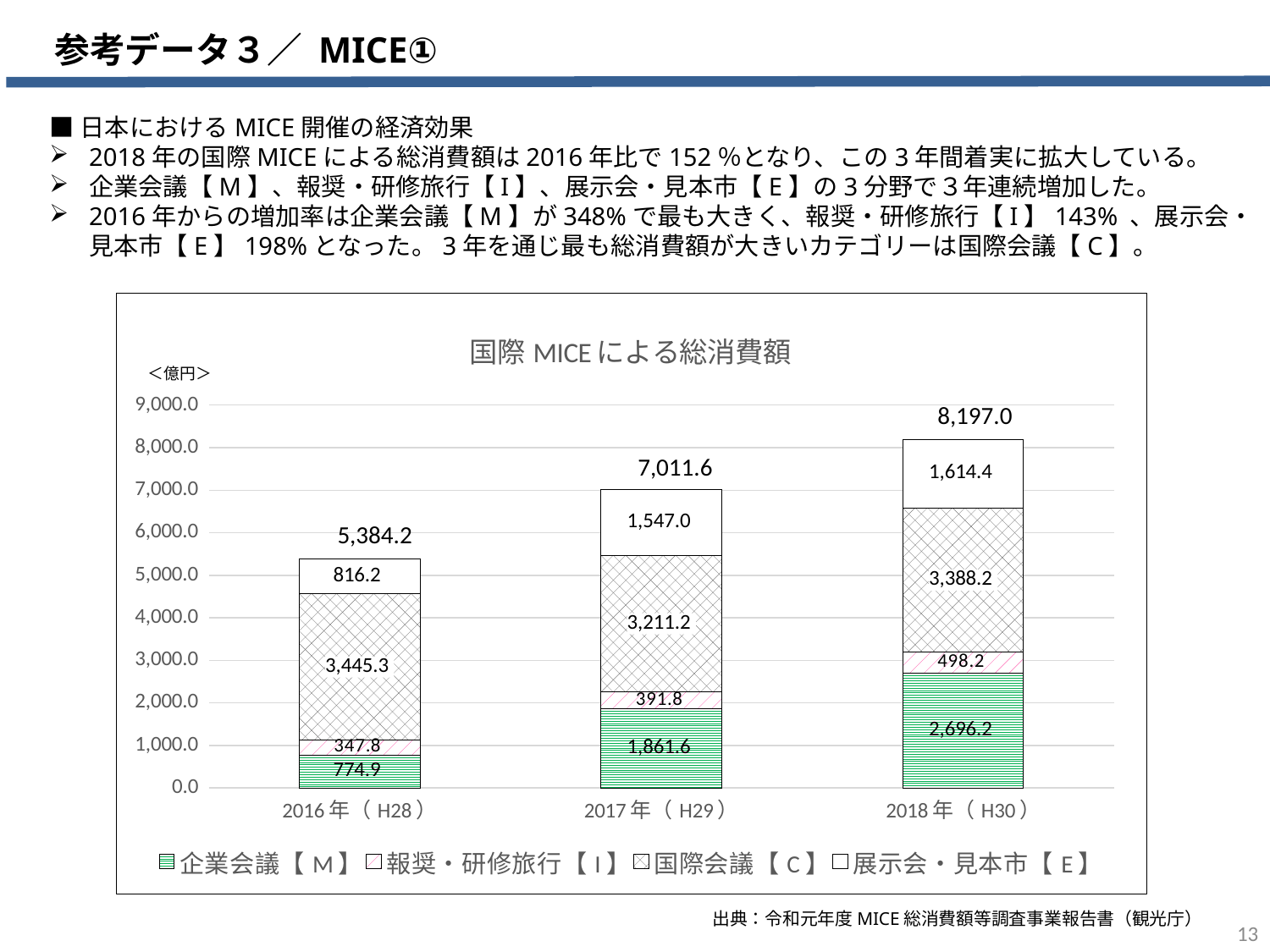
「国際 MICE による総消費額」のグラフはどの種類のグラフですか？ 積み上げ棒グラフ 「国際 MICE による総消費額」のグラフには、いくつの年（カテゴリー）が表示されていますか？ 3 「国際 MICE による総消費額」のグラフで、2016年（H28）の企業会議【M】の値はいくらですか？ 774.9 「国際 MICE による総消費額」のグラフで、2018年（H30）と2016年（H28）の合計の差はいくらですか？ 2,812.8 「国際 MICE による総消費額」のグラフで、2017年（H29）の展示会・見本市【E】の値はいくらですか？ 1,547.0 「国際 MICE による総消費額」のグラフで、合計が最も大きい年はどれですか？ 2018年（H30） 「国際 MICE による総消費額」のグラフで、2017年（H29）の企業会議【M】と2016年（H28）の企業会議【M】ではどちらが大きいですか？ 2017年（H29） 「国際 MICE による総消費額」のグラフで、合計が最も小さい年はどれですか？ 2016年（H28） 「国際 MICE による総消費額」のグラフで、2018年（H30）の国際会議【C】の値はいくらですか？ 3,388.2 「国際 MICE による総消費額」のグラフで、2018年（H30）の積み上げ棒の合計はいくらですか？ 8,197.0 「国際 MICE による総消費額」のグラフで、合計は2016年から2018年にかけて増加していますか、減少していますか？ 増加 「国際 MICE による総消費額」のグラフで、凡例にはいくつの系列がありますか？ 4